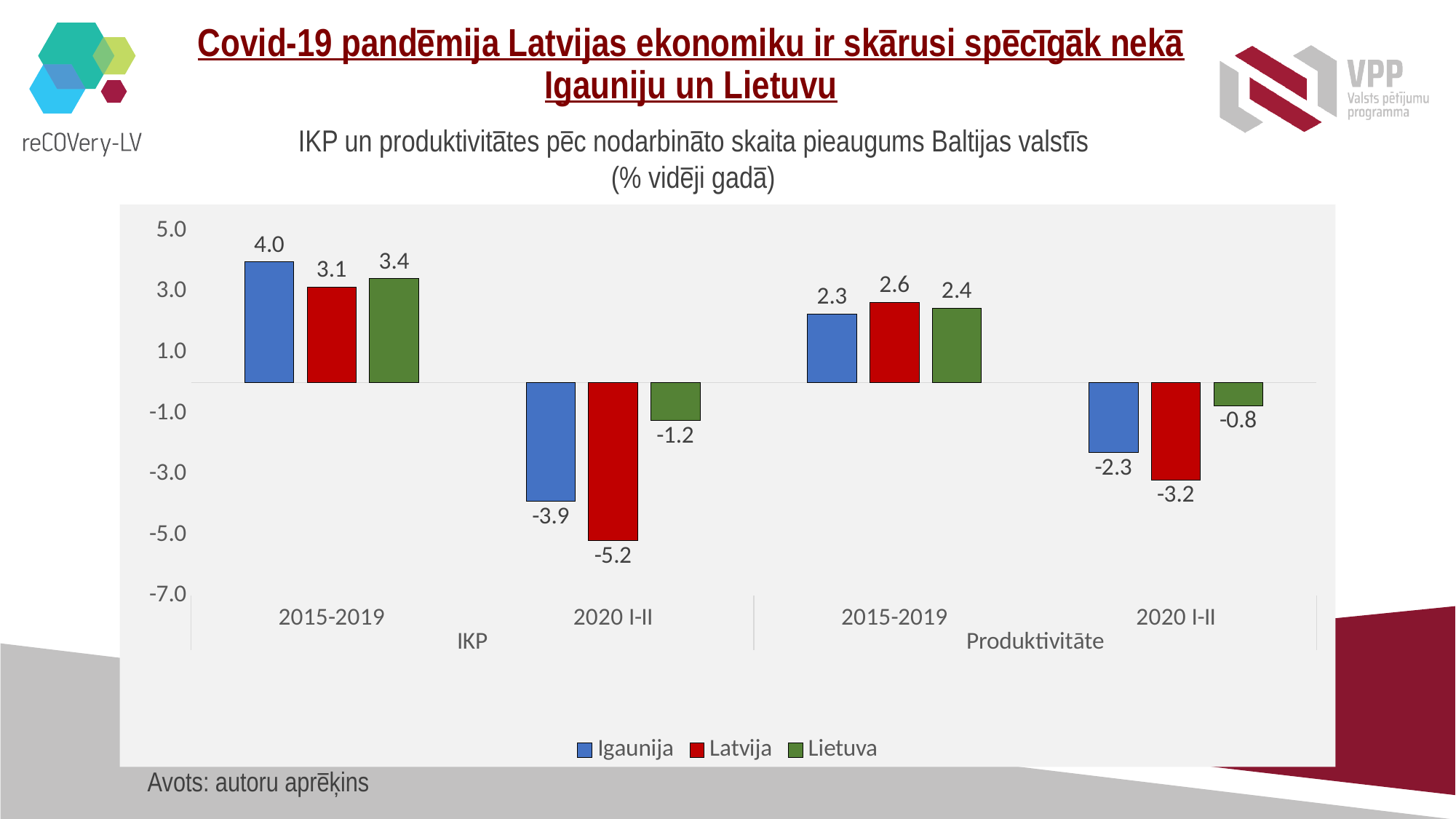
Which country has the lowest value in the IKP 2020 I-II group? Latvija What is the value for Latvija in the IKP 2020 I-II group? -5.2 What is the value for Lietuva in the Produktivitāte 2020 I-II group? -0.8 Which colour represents Latvija in the chart? Red What is the value for Igaunija in the IKP 2015-2019 group? 4.0 Which country has the highest value in the IKP 2015-2019 group? Igaunija What is the difference between the Lietuva values for IKP 2015-2019 and IKP 2020 I-II? 4.6 What is the difference between the Igaunija and Latvija values in the IKP 2020 I-II group? 1.3 Which is larger in the Produktivitāte 2020 I-II group: the value for Igaunija or the value for Lietuva? Lietuva What is the value for Latvija in the Produktivitāte 2015-2019 group? 2.6 How many series does the legend list? 3 What kind of chart is shown on the slide? Bar chart